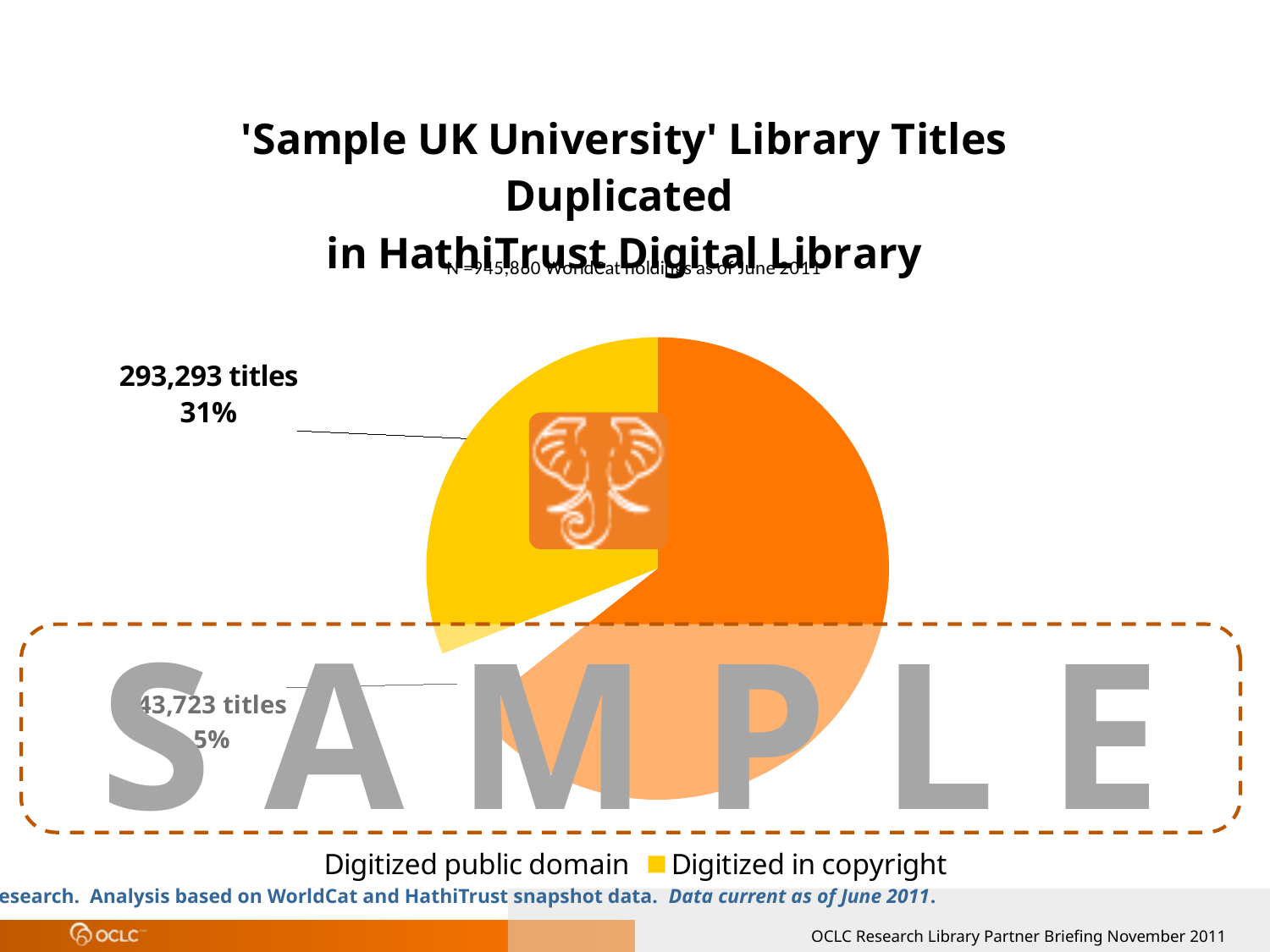
Which labelled slice is larger: the one with 293,293 titles or the one with 43,723 titles? 293,293 titles How many titles are in the 'Digitized in copyright' slice of the pie chart? 293,293 titles What percentage is shown for the smallest labelled slice of the pie chart? 5% What kind of chart is shown on the slide? pie chart Which labelled slice of the pie is the smallest? 43,723 titles (5%) By how many percentage points does the 31% slice exceed the 5% slice? 26% What colour does the legend use for 'Digitized in copyright'? yellow How many slices does the pie chart have? 3 How many titles are in the smallest labelled slice of the pie chart? 43,723 titles What is the title of the chart? 'Sample UK University' Library Titles Duplicated in HathiTrust Digital Library What share of the pie does the 'Digitized in copyright' slice represent? 31% What is the difference in titles between the 31% slice and the 5% slice? 249,570 titles